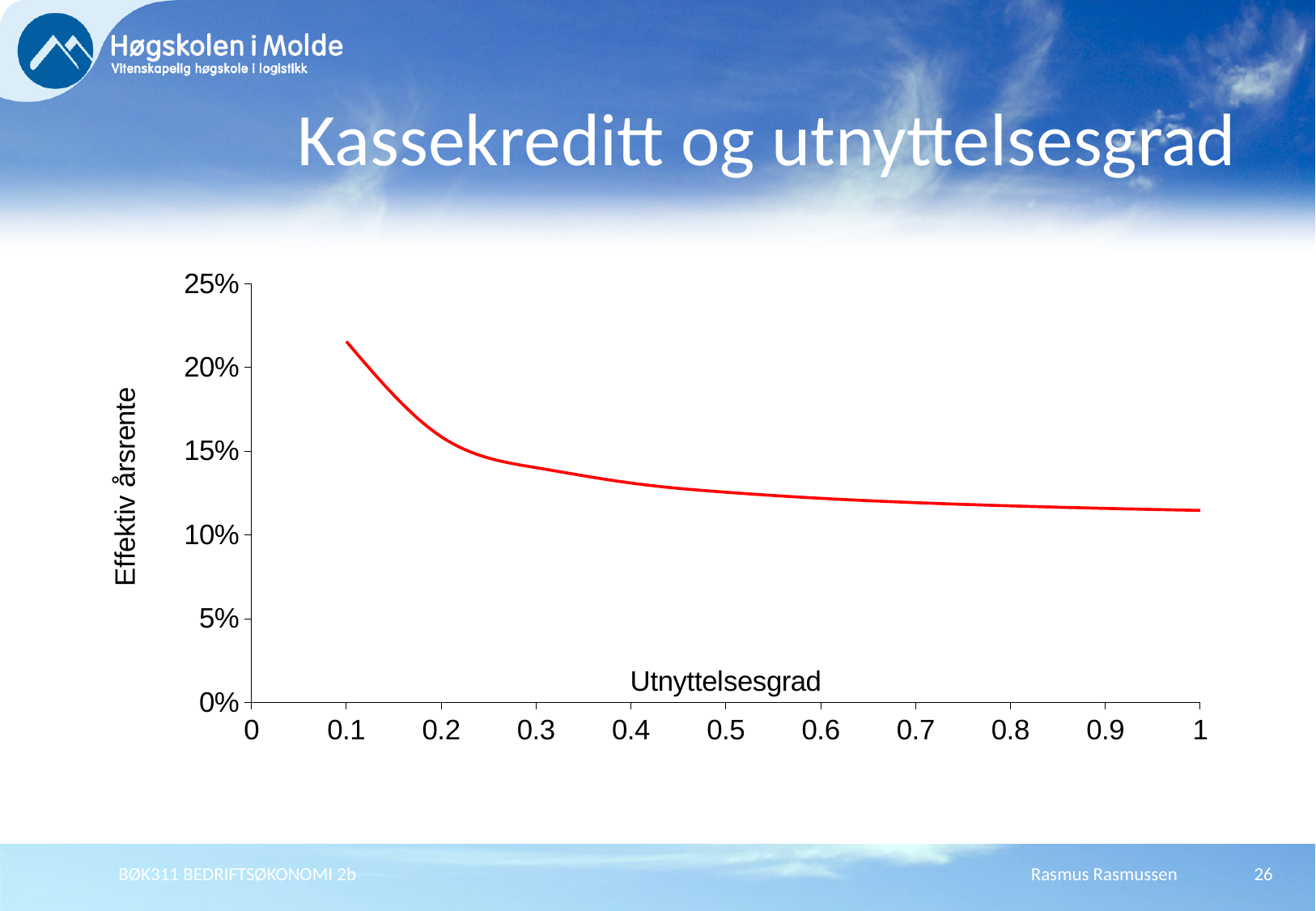
What is the label on the vertical axis of the chart? Effektiv årsrente What is the label on the horizontal axis of the chart? Utnyttelsesgrad At which Utnyttelsesgrad shown on the x axis is Effektiv årsrente lowest? 1 Is the value of Effektiv årsrente at Utnyttelsesgrad 0.3 greater or less than 15%? less Is the value of Effektiv årsrente at Utnyttelsesgrad 0.1 greater or less than 20%? greater Is the value of Effektiv årsrente at Utnyttelsesgrad 0.5 greater or less than 10%? greater Does the effective annual interest rate (Effektiv årsrente) rise or fall as Utnyttelsesgrad increases from 0.1 to 1? fall Which has the higher Effektiv årsrente: Utnyttelsesgrad 0.1 or Utnyttelsesgrad 1? 0.1 At which Utnyttelsesgrad shown on the x axis is Effektiv årsrente highest? 0.1 What kind of chart is shown on the slide? line chart